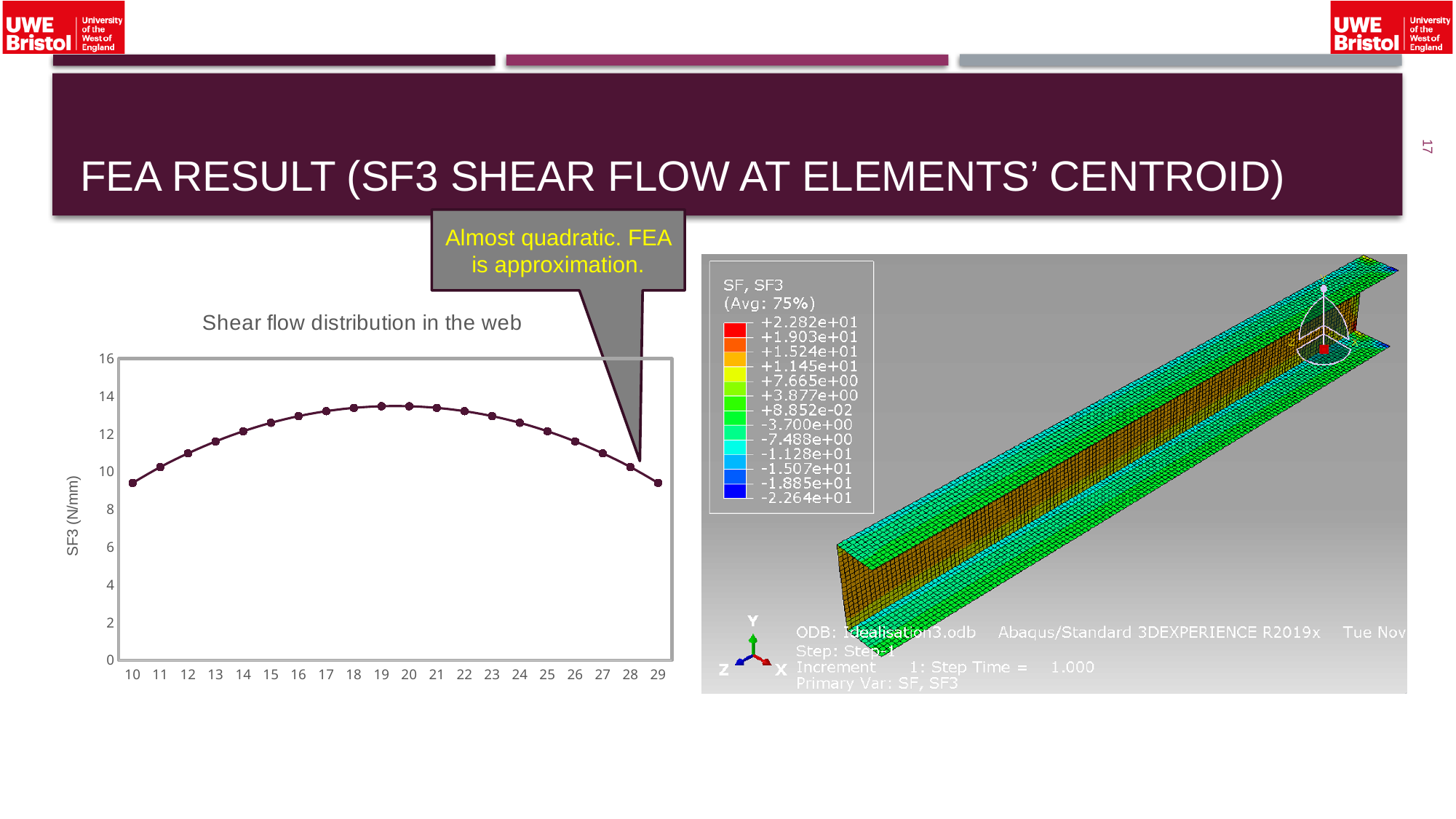
What type of chart is "Shear flow distribution in the web"? Line chart In the "Shear flow distribution in the web" chart, is the value at x = 15 greater or less than 12? greater What is the y-axis label of the "Shear flow distribution in the web" chart? SF3 (N/mm) In the "Shear flow distribution in the web" chart, do the values rise or fall from x = 20 to x = 29? fall In the "Shear flow distribution in the web" chart, do the values rise or fall from x = 10 to x = 19? rise What is the title of the chart on the left of the slide? Shear flow distribution in the web In the "Shear flow distribution in the web" chart, is the value at x = 20 greater or less than 12? greater In the "Shear flow distribution in the web" chart, is the value at x = 29 greater or less than 10? less How many data points are plotted in the "Shear flow distribution in the web" chart? 20 In the "Shear flow distribution in the web" chart, which has the larger value: x = 14 or x = 17? x = 17 In the "Shear flow distribution in the web" chart, which has the larger value: x = 10 or x = 20? x = 20